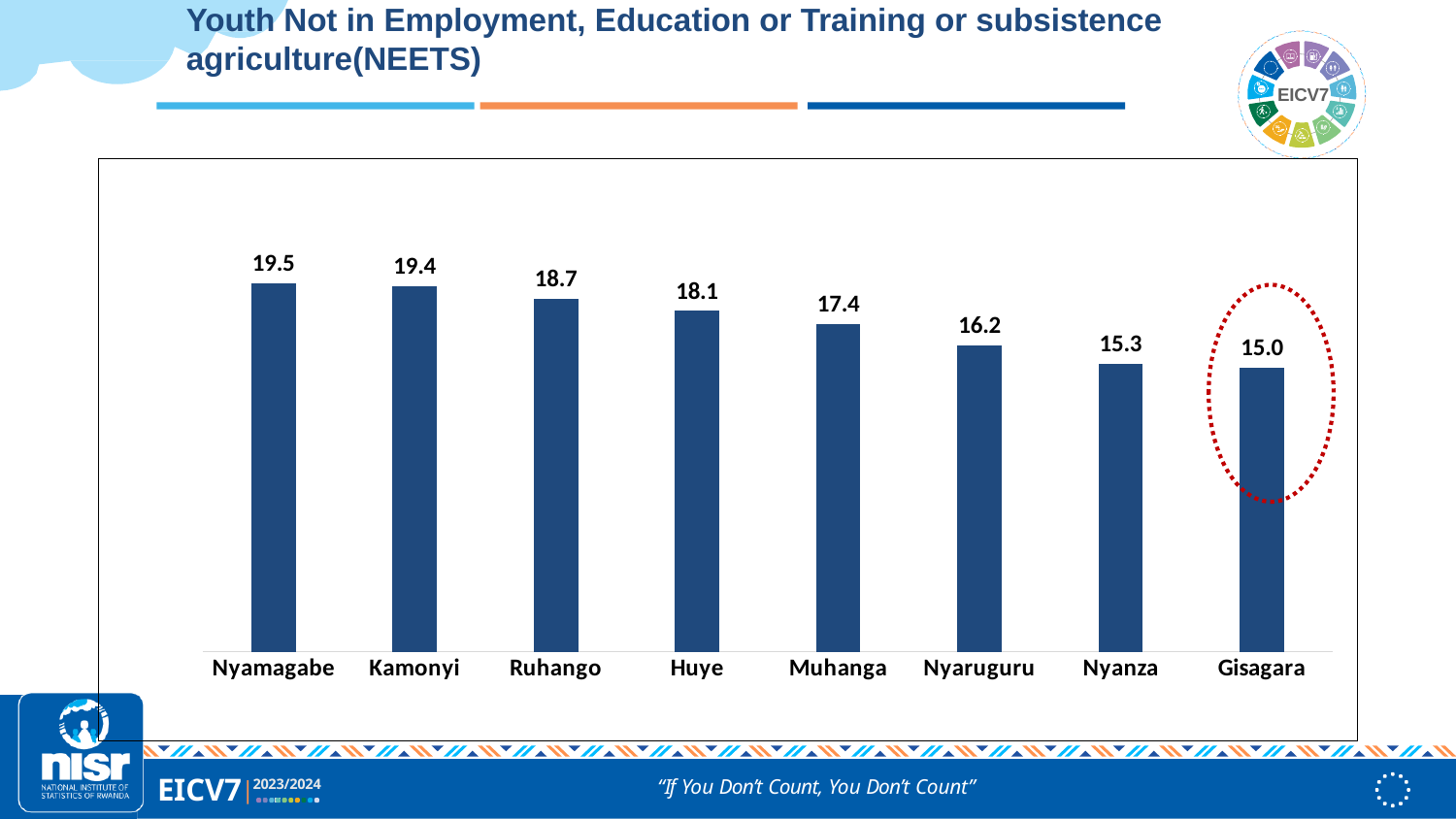
What is the value for Gisagara? 15.0 What kind of chart is shown on the slide? Bar chart Which district has the lowest value? Gisagara What is the difference between the values for Ruhango and Huye? 0.6 Which is larger, the value for Nyaruguru or the value for Nyanza? Nyaruguru Do the values rise or fall from left to right across the districts? Fall Which district has the highest value? Nyamagabe What is the value for Nyamagabe? 19.5 Which district's bar is circled with a red dotted outline? Gisagara What is the difference between the values for Nyamagabe and Gisagara? 4.5 What is the value for Muhanga? 17.4 How many districts are shown in the chart? 8